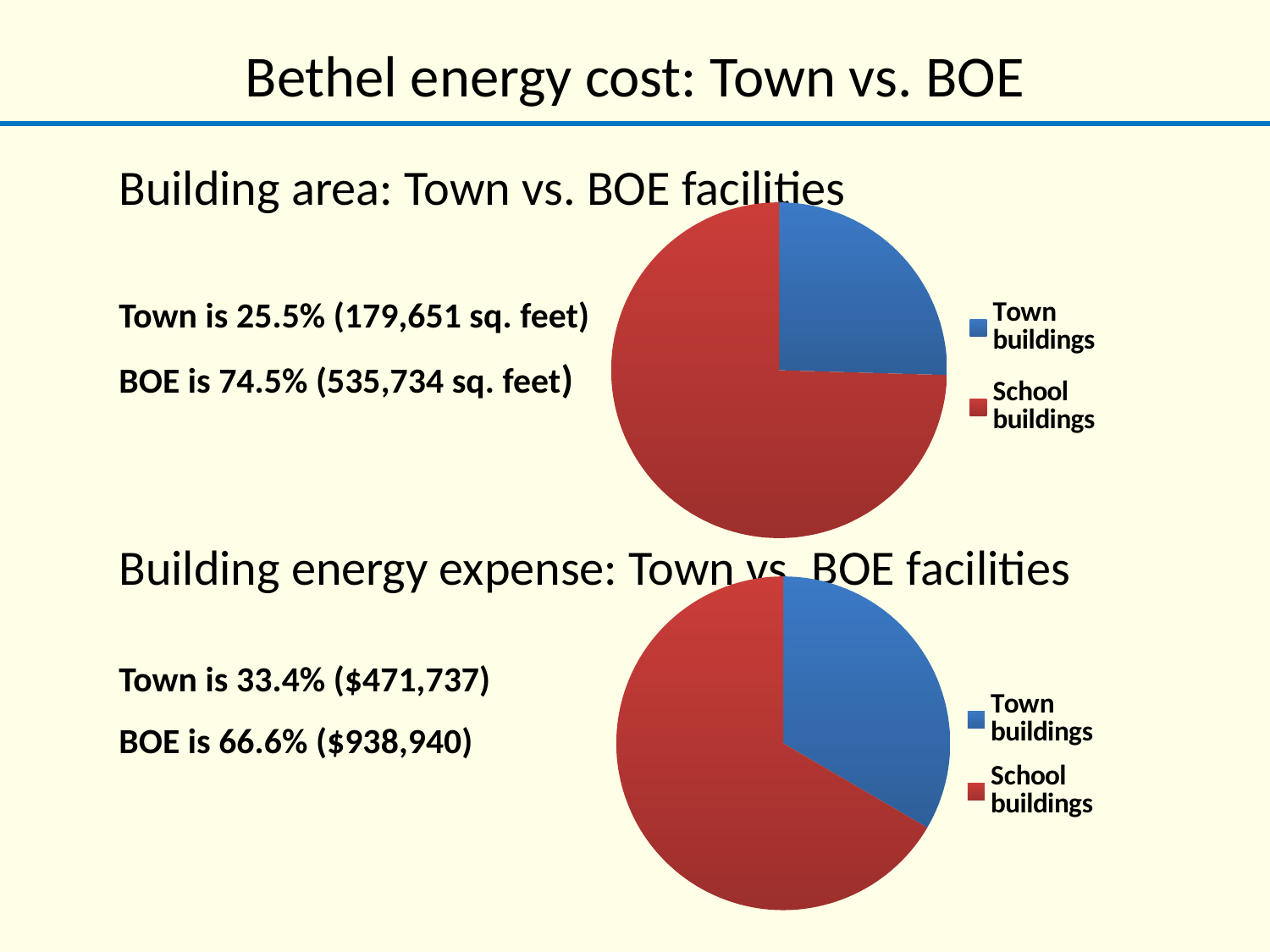
What kind of chart is used for the building area comparison on the slide? Pie chart In the building energy expense pie chart, which category has the smaller slice? Town buildings How many categories does the legend of the building area pie chart list? 2 In the building area pie chart, what share of the pie do School buildings represent? 74.5% In the building energy expense pie chart, what share of the pie do Town buildings represent? 33.4% In the building energy expense pie chart, what is the energy expense for BOE (School) buildings? $938,940 In the building area pie chart, what is the building area for Town buildings in square feet? 179,651 sq. feet In the building energy expense pie chart, what is the difference in percentage points between the BOE share and the Town share? 33.2 percentage points In the building area pie chart, what is the building area for BOE (School) buildings in square feet? 535,734 sq. feet In the building area pie chart, which category has the larger slice? School buildings In the building area pie chart, what share of the pie do Town buildings represent? 25.5% In the building energy expense pie chart, what is the energy expense for Town buildings? $471,737